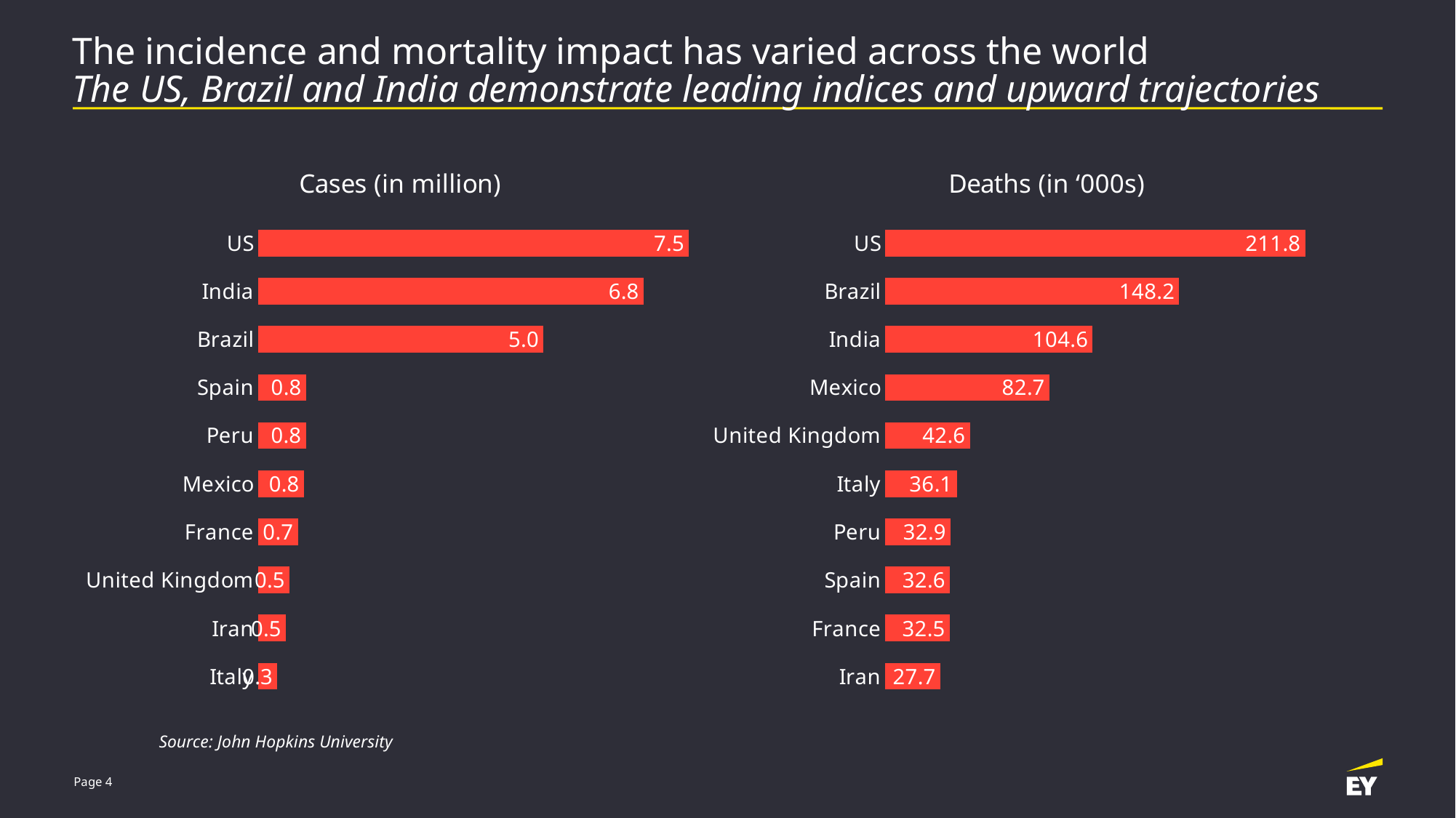
In the 'Cases (in million)' chart, what is the difference between the US and Brazil values? 2.5 What source is cited for the charts on the slide? John Hopkins University In the 'Cases (in million)' chart, what is the value for France? 0.7 In the 'Deaths (in '000s)' chart, which country has the lowest value? Iran What kind of chart is the 'Deaths (in '000s)' chart? Bar chart In the 'Deaths (in '000s)' chart, which country has the highest value? US In the 'Cases (in million)' chart, which country has the lowest value? Italy In the 'Deaths (in '000s)' chart, which is larger, the value for United Kingdom or the value for Italy? United Kingdom In the 'Deaths (in '000s)' chart, what is the difference between the Brazil and India values? 43.6 In the 'Cases (in million)' chart, what is the value for India? 6.8 In the 'Deaths (in '000s)' chart, what is the value for Mexico? 82.7 How many countries are shown in the 'Cases (in million)' chart? 10